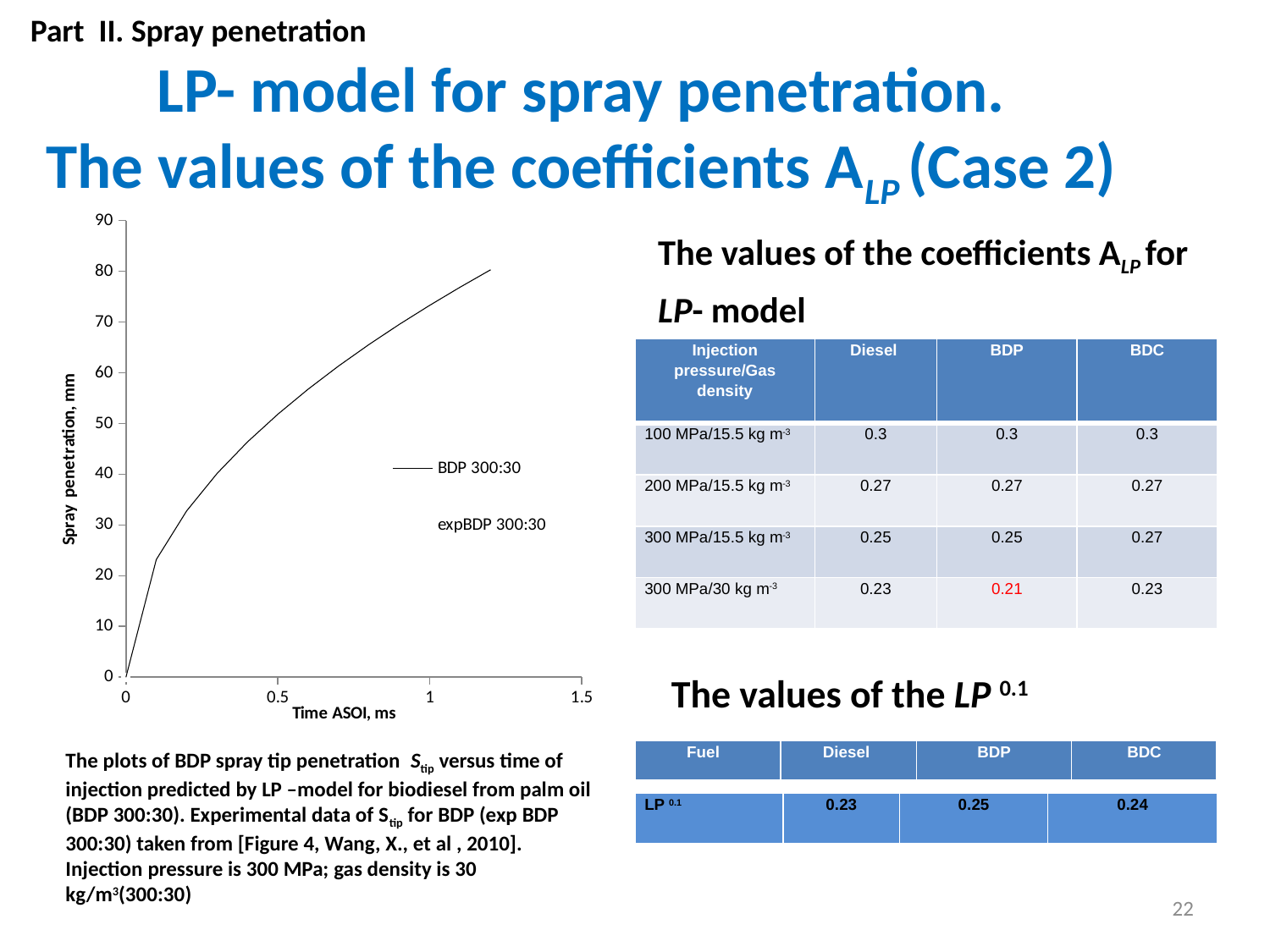
In the spray penetration chart, does the BDP 300:30 curve rise or fall as time increases? rise What is the highest value shown on the y axis of the spray penetration chart? 90 What is the label of the x axis of the spray penetration chart? Time ASOI, ms In the spray penetration chart, is the BDP 300:30 value at 0.2 ms greater or less than 40? less What kind of chart is shown on the left of the slide? line chart In the spray penetration chart, is the BDP 300:30 value at 1 ms greater or less than 70? greater How many series does the legend of the spray penetration chart list? 2 What is the label of the y axis of the spray penetration chart? Spray penetration, mm In the spray penetration chart, is the BDP 300:30 value at 0.5 ms greater or less than 40? greater